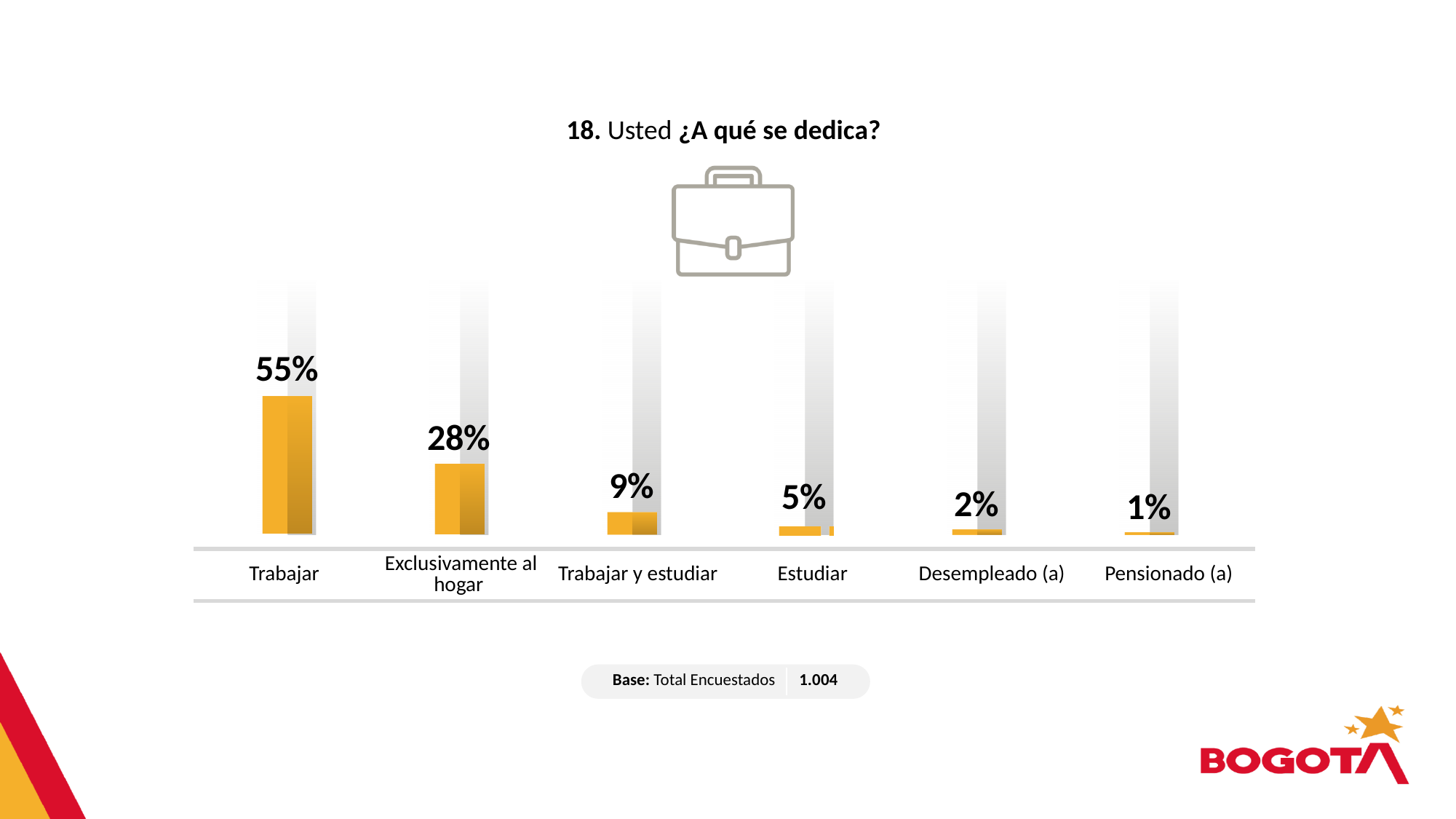
What kind of chart is shown on the slide? Bar chart What percentage is shown for "Trabajar y estudiar"? 9% How many categories are shown in the chart? 6 Which category has the lowest value? Pensionado (a) What is the value shown for "Exclusivamente al hogar"? 28% What is the difference between the values for "Trabajar" and "Exclusivamente al hogar"? 27% Which is larger, the value for "Estudiar" or the value for "Desempleado (a)"? Estudiar What is the value for "Pensionado (a)"? 1% What is the base (total number of respondents) shown below the chart? 1.004 Which category has the highest value? Trabajar Do the values rise or fall from left to right across the categories? Fall What percentage of respondents answered "Trabajar"? 55%